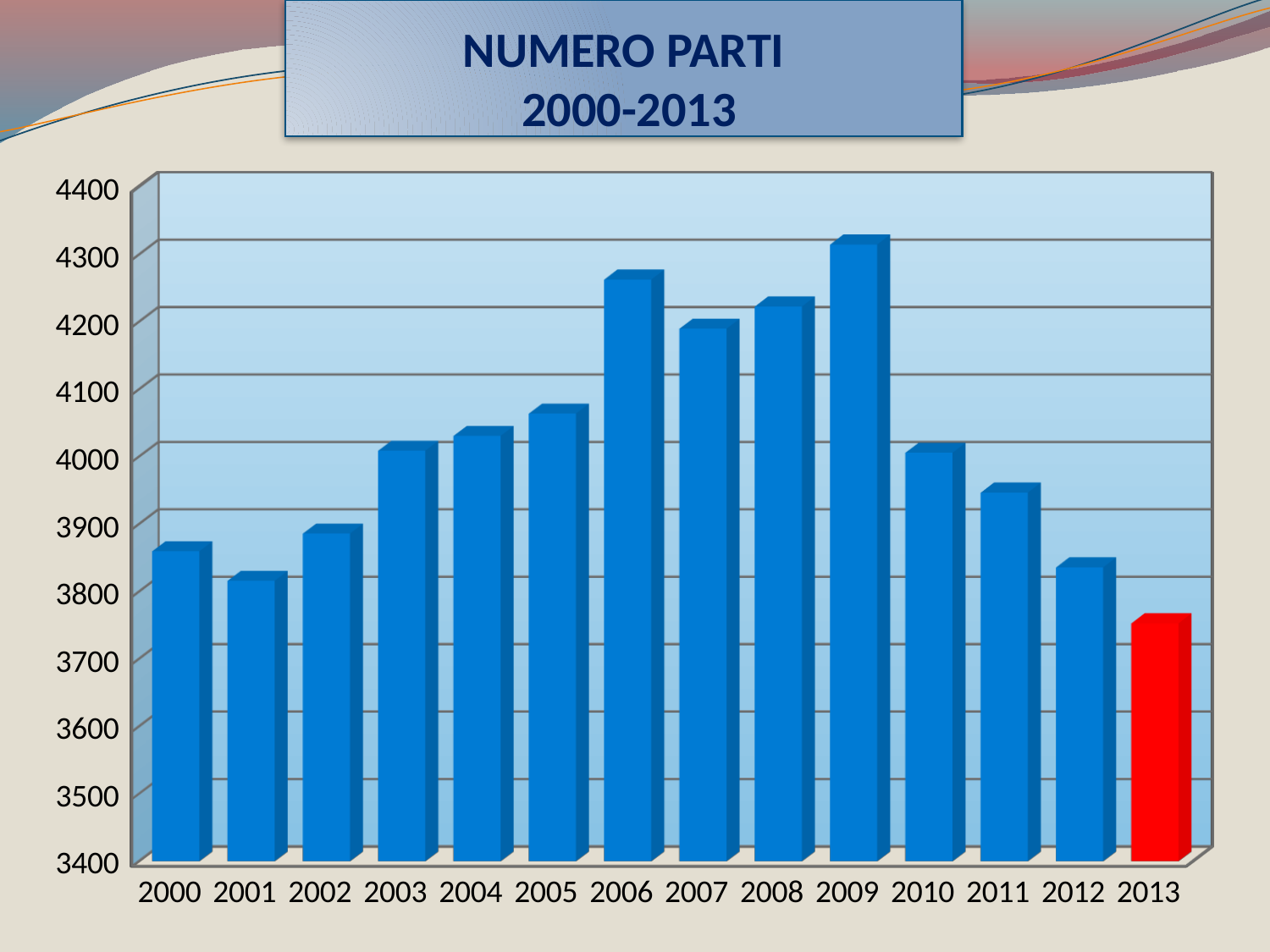
Which year has the lowest number of births (parti)? 2013 Do the values rise or fall from 2009 to 2013? fall Is the value for 2001 greater or less than 3900? less What kind of chart is shown on the slide? bar chart Is the value for 2007 greater or less than 4100? greater Is the value for 2013 greater or less than 3800? less Which year's bar is coloured red instead of blue? 2013 Which year has the larger value, 2012 or 2013? 2012 Which year has the larger value, 2006 or 2007? 2006 How many years are plotted on the x axis? 14 Which year has the highest number of births (parti)? 2009